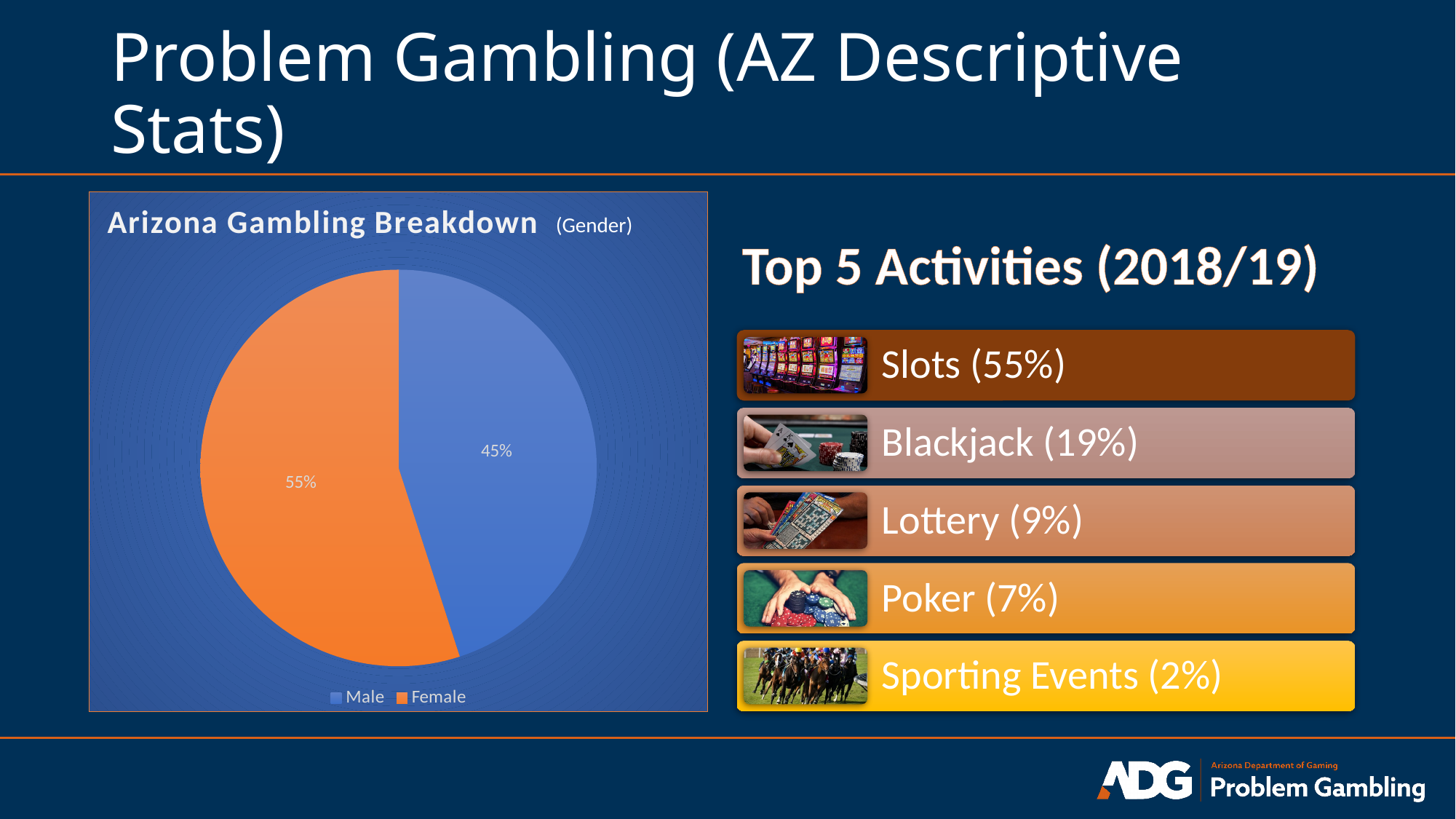
What percentage of the pie chart is labelled for Male? 45% How many entries does the pie chart's legend list? 2 What percentage of the pie chart is labelled for Female? 55% Is the Male share in the pie chart greater or less than 50%? less What colour represents Male in the pie chart? blue Which category has the largest slice in the pie chart? Female Which category has the smallest slice in the pie chart? Male What kind of chart is shown on the slide? pie chart Which slice is larger in the pie chart, Male or Female? Female By how many percentage points does the Female slice exceed the Male slice? 10% What is the title of the pie chart? Arizona Gambling Breakdown How many slices does the pie chart have? 2